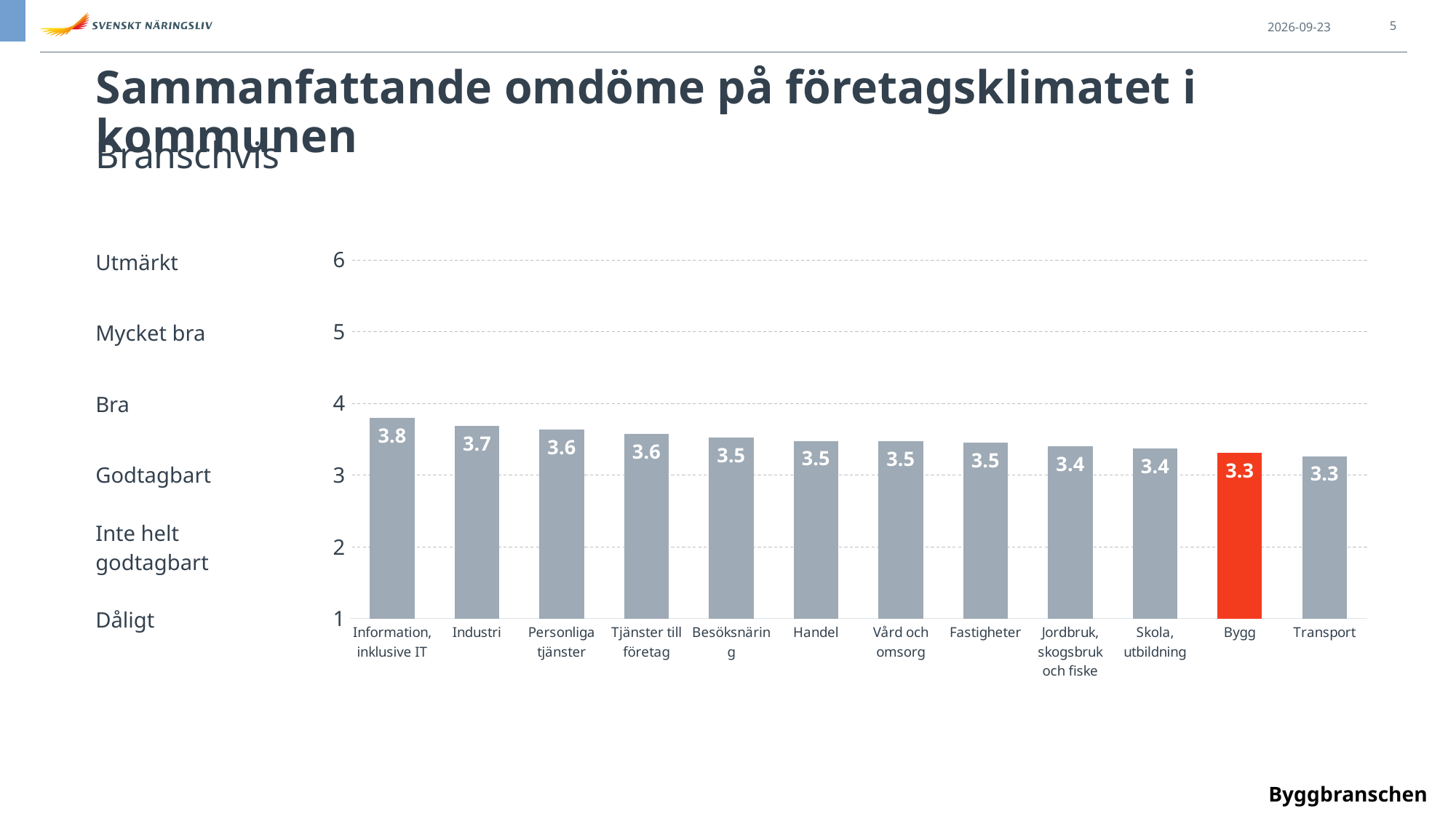
Which category has the highest value? Information, inklusive IT Is the value for Personliga tjänster greater or less than 4? less What is the value for Bygg? 3.3 What is the difference between the values for Information, inklusive IT and Transport? 0.5 Which is larger, the value for Industri or the value for Skola, utbildning? Industri What is the value for Industri? 3.7 How many categories are shown on the x axis? 12 What is the value for Handel? 3.5 What kind of chart is shown on the slide? bar chart Which bar is highlighted in red? Bygg What is the value for Jordbruk, skogsbruk och fiske? 3.4 Do the values generally rise or fall from left to right along the x axis? fall